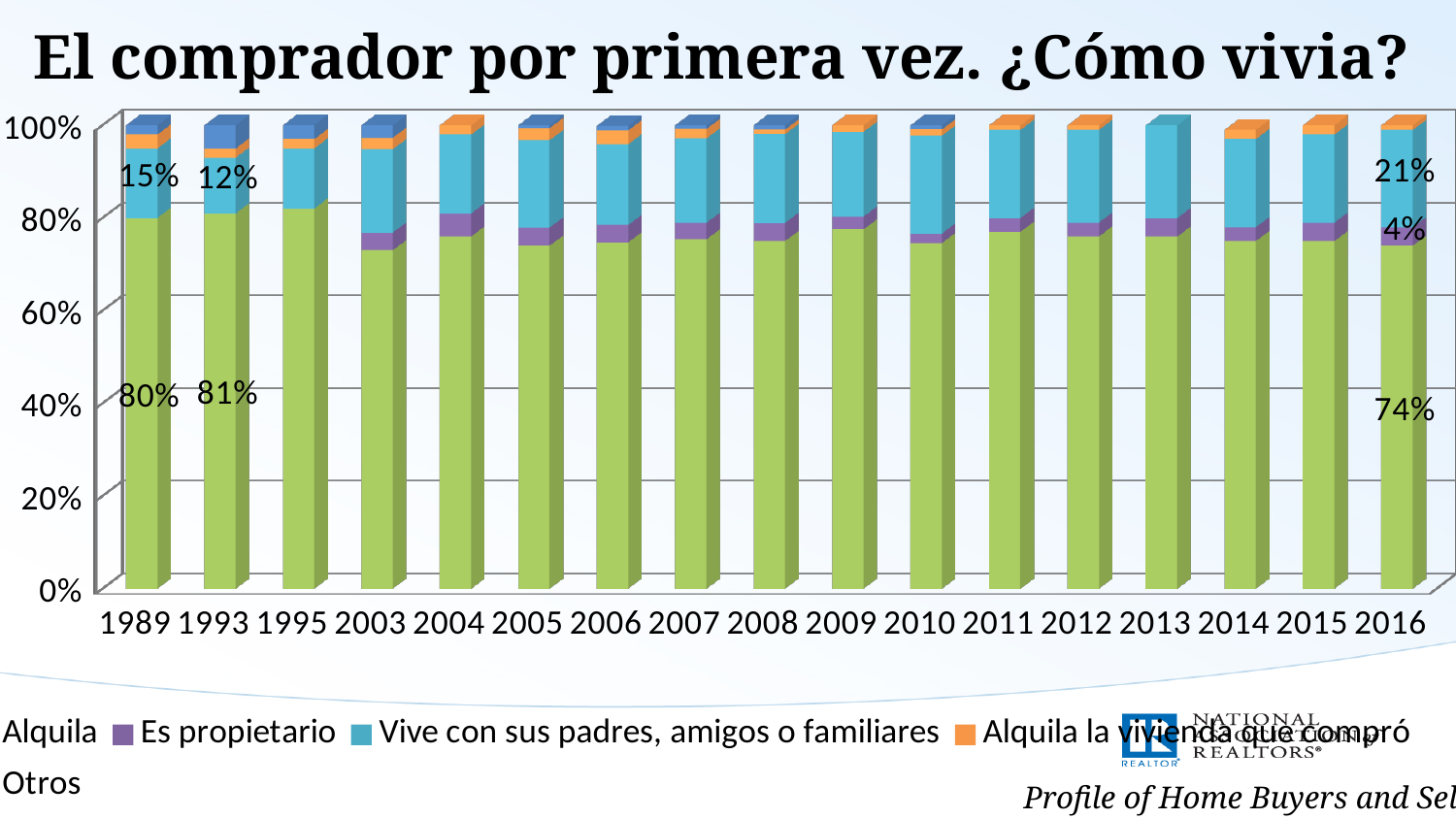
By how many percentage points did the 'Alquila' share fall from 1993 to 2016? 7 percentage points What is the value for 'Es propietario' in 2016? 4% What is the value for 'Alquila' in 2016? 74% What is the value for 'Alquila' in 1993? 81% How many years are shown on the x axis? 17 What is the value for 'Vive con sus padres, amigos o familiares' in 2016? 21% How many series does the legend list? 5 What percentage of first-time buyers were in the 'Alquila' category in 1989? 80% Is the 'Alquila' value for 2003 greater or less than 80%? less What is the value for 'Vive con sus padres, amigos o familiares' in 1993? 12% What is the value for 'Vive con sus padres, amigos o familiares' in 1989? 15% Which year has the larger share for 'Vive con sus padres, amigos o familiares': 1989 or 2016? 2016